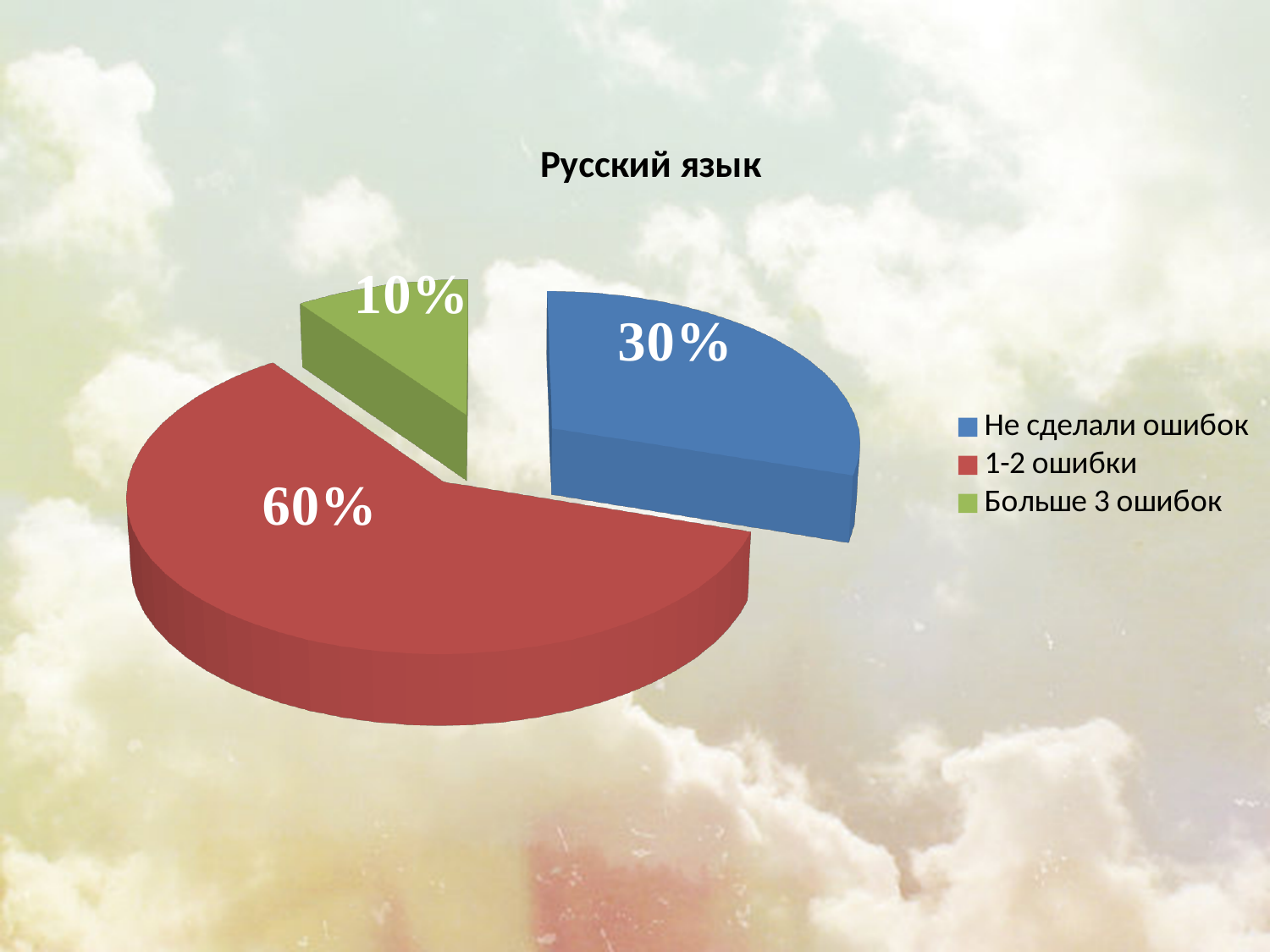
Which is larger: the share for "Не сделали ошибок" or the share for "Больше 3 ошибок"? Не сделали ошибок What percentage is shown for the "1-2 ошибки" slice? 60% How many categories does the legend list? 3 What is the combined share of the "Не сделали ошибок" and "Больше 3 ошибок" slices? 40% What is the difference in percentage points between the "1-2 ошибки" slice and the "Не сделали ошибок" slice? 30 What percentage is shown for the "Больше 3 ошибок" slice? 10% What type of chart is shown on the slide? Pie chart What colour is the slice for "Больше 3 ошибок"? Green Which category has the smallest share of the pie? Больше 3 ошибок What is the title of the chart? Русский язык What percentage is shown for the "Не сделали ошибок" slice? 30% Which category has the largest share of the pie? 1-2 ошибки